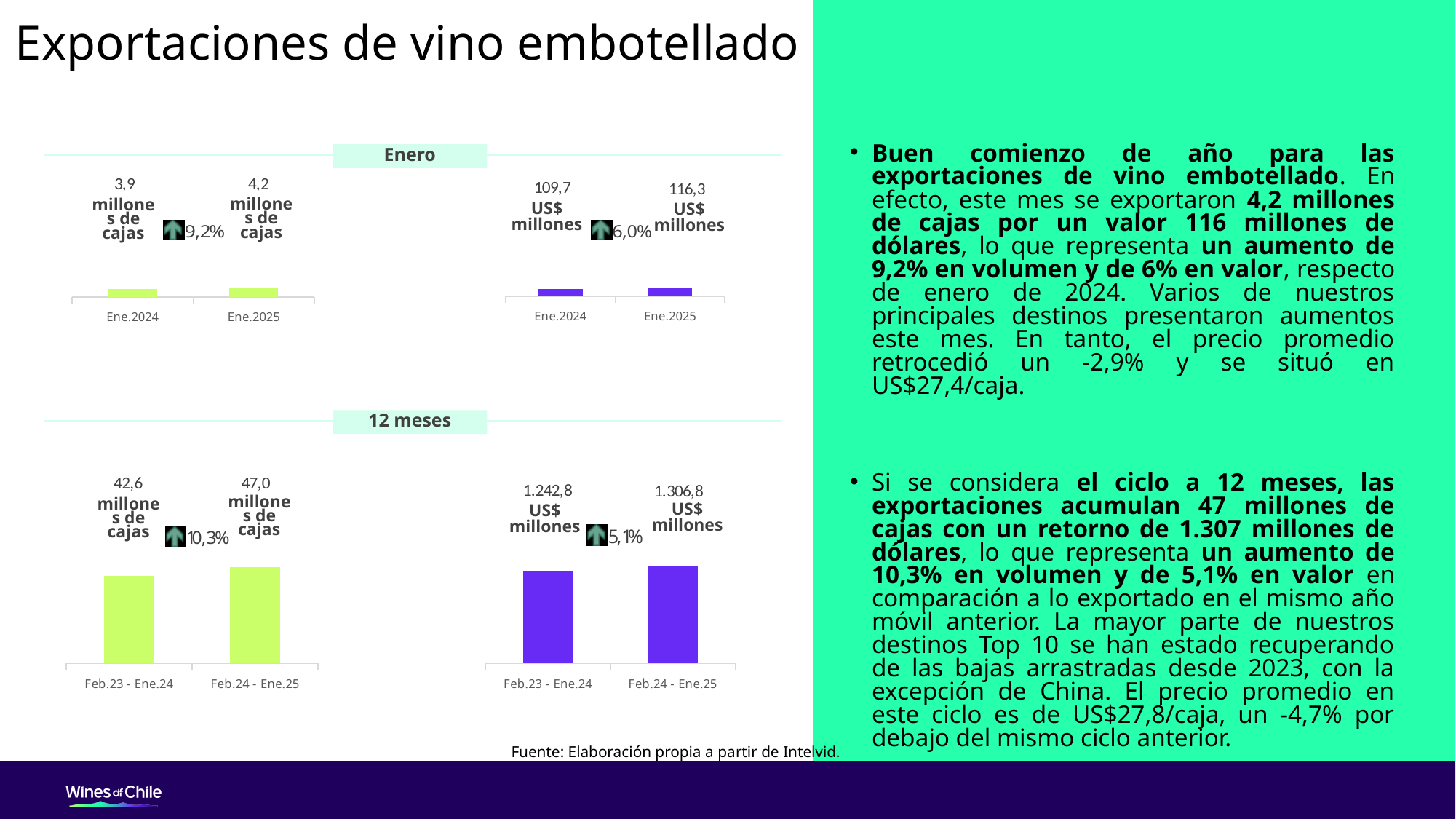
In the Enero volume chart (top left), what is the value for Ene.2025? 4,2 millones de cajas In the Enero volume chart (top left), what is the value for Ene.2024? 3,9 millones de cajas In the Enero value chart (top right), what is the difference between Ene.2025 and Ene.2024? 6,6 US$ millones What type of chart is used in the 12 meses value chart (bottom right)? bar chart In the Enero value chart (top right, US$ millones), what is the value for Ene.2024? 109,7 US$ millones How many bars does the 12 meses volume chart (bottom left) have? 2 In the Enero volume chart (top left), is the value for Ene.2024 larger or smaller than the value for Ene.2025? smaller In the Enero value chart (top right, US$ millones), what is the value for Ene.2025? 116,3 US$ millones In the 12 meses value chart (bottom right), which period has the higher value? Feb.24 - Ene.25 In the 12 meses value chart (bottom right, US$ millones), what is the value for Feb.23 - Ene.24? 1.242,8 US$ millones In the 12 meses volume chart (bottom left), what is the difference between Feb.24 - Ene.25 and Feb.23 - Ene.24? 4,4 millones de cajas In the 12 meses volume chart (bottom left), what is the value for Feb.24 - Ene.25? 47,0 millones de cajas